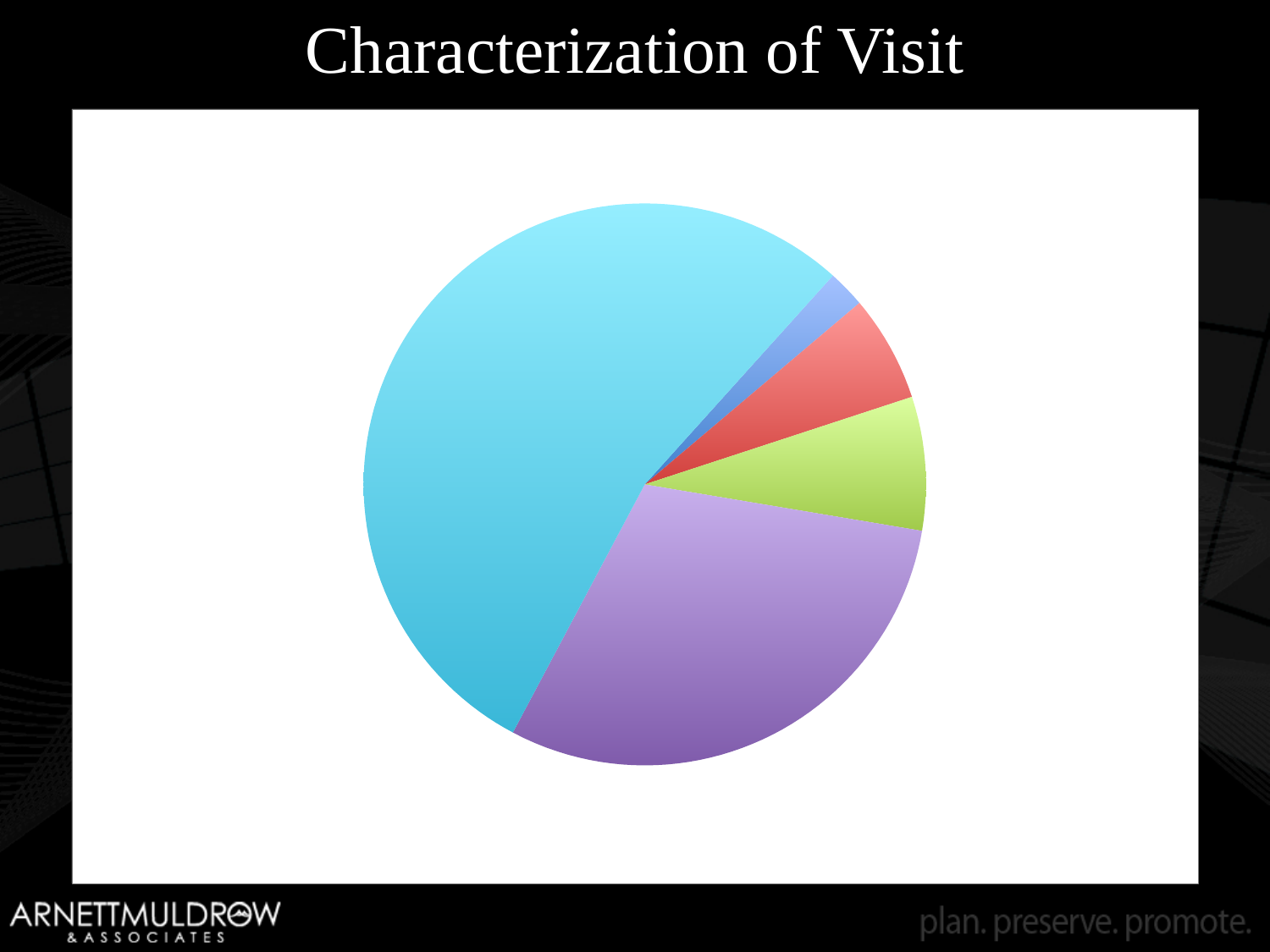
Which colour slice is the smallest in the pie chart? blue Which colour slice is the largest in the pie chart? light blue (cyan) What is the title of the slide containing the pie chart? Characterization of Visit What kind of chart is shown on the slide? pie chart How many slices does the pie chart have? 5 Which slice is larger, the purple slice or the green slice? purple Which slice is larger, the red slice or the blue slice? red Does the pie chart display a legend? No